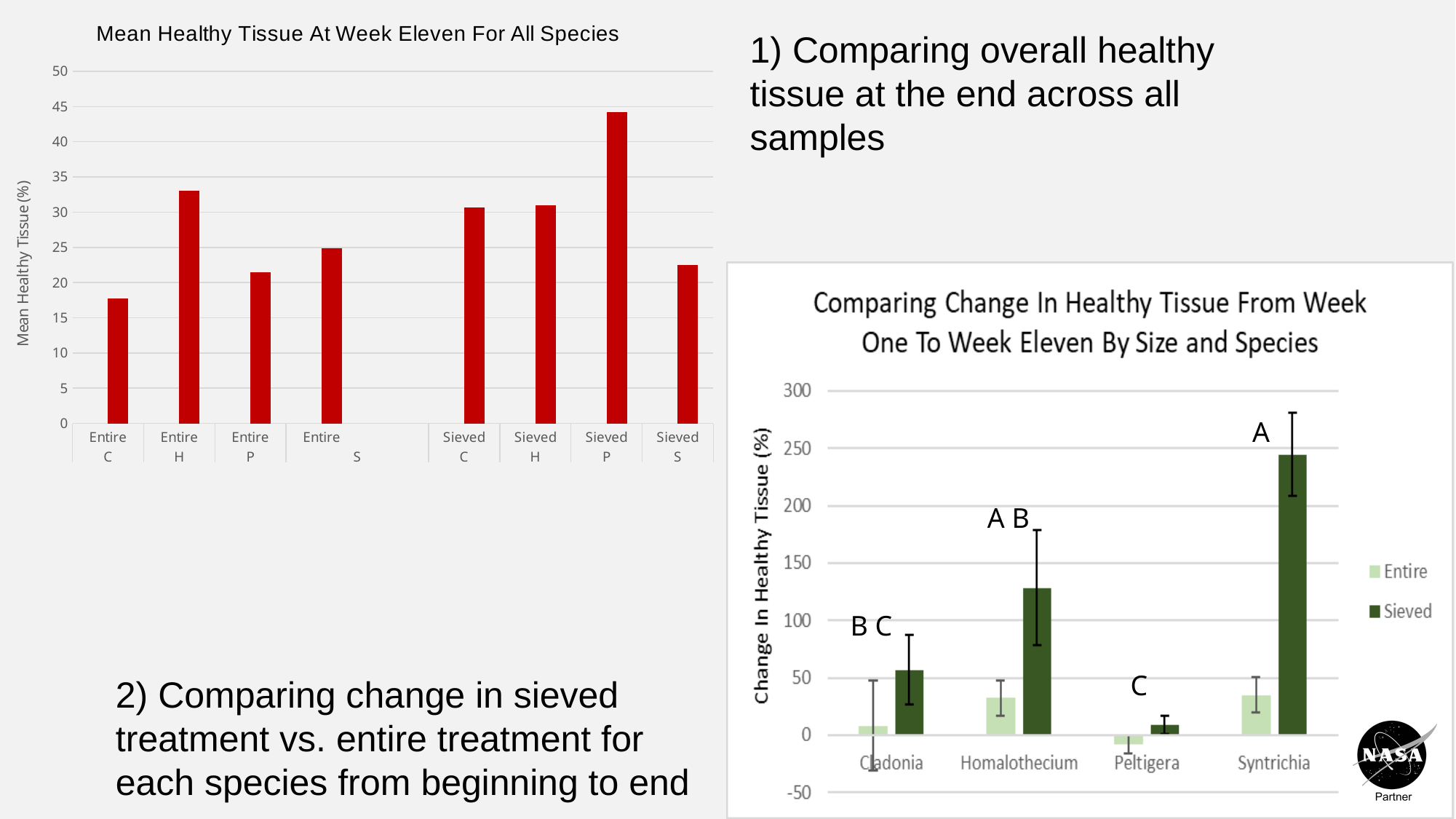
On the chart titled 'Mean Healthy Tissue At Week Eleven For All Species', which category has the highest bar? Sieved P On the chart titled 'Mean Healthy Tissue At Week Eleven For All Species', is the value for Sieved S greater or less than 25? less On the chart titled 'Comparing Change In Healthy Tissue From Week One To Week Eleven By Size and Species', is the Sieved value for Syntrichia greater or less than 200? greater On the chart titled 'Mean Healthy Tissue At Week Eleven For All Species', is the value for Entire C greater or less than 20? less On the chart titled 'Comparing Change In Healthy Tissue From Week One To Week Eleven By Size and Species', what is the label of the y axis? Change In Healthy Tissue (%) On the chart titled 'Mean Healthy Tissue At Week Eleven For All Species', which is larger, Entire P or Sieved P? Sieved P On the chart titled 'Mean Healthy Tissue At Week Eleven For All Species', which category has the lowest bar? Entire C On the chart titled 'Comparing Change In Healthy Tissue From Week One To Week Eleven By Size and Species', how many series does the legend list? 2 On the chart titled 'Mean Healthy Tissue At Week Eleven For All Species', how many categories are plotted? 8 On the chart titled 'Comparing Change In Healthy Tissue From Week One To Week Eleven By Size and Species', which species has the highest Sieved bar? Syntrichia What kind of chart is the one titled 'Comparing Change In Healthy Tissue From Week One To Week Eleven By Size and Species'? bar chart